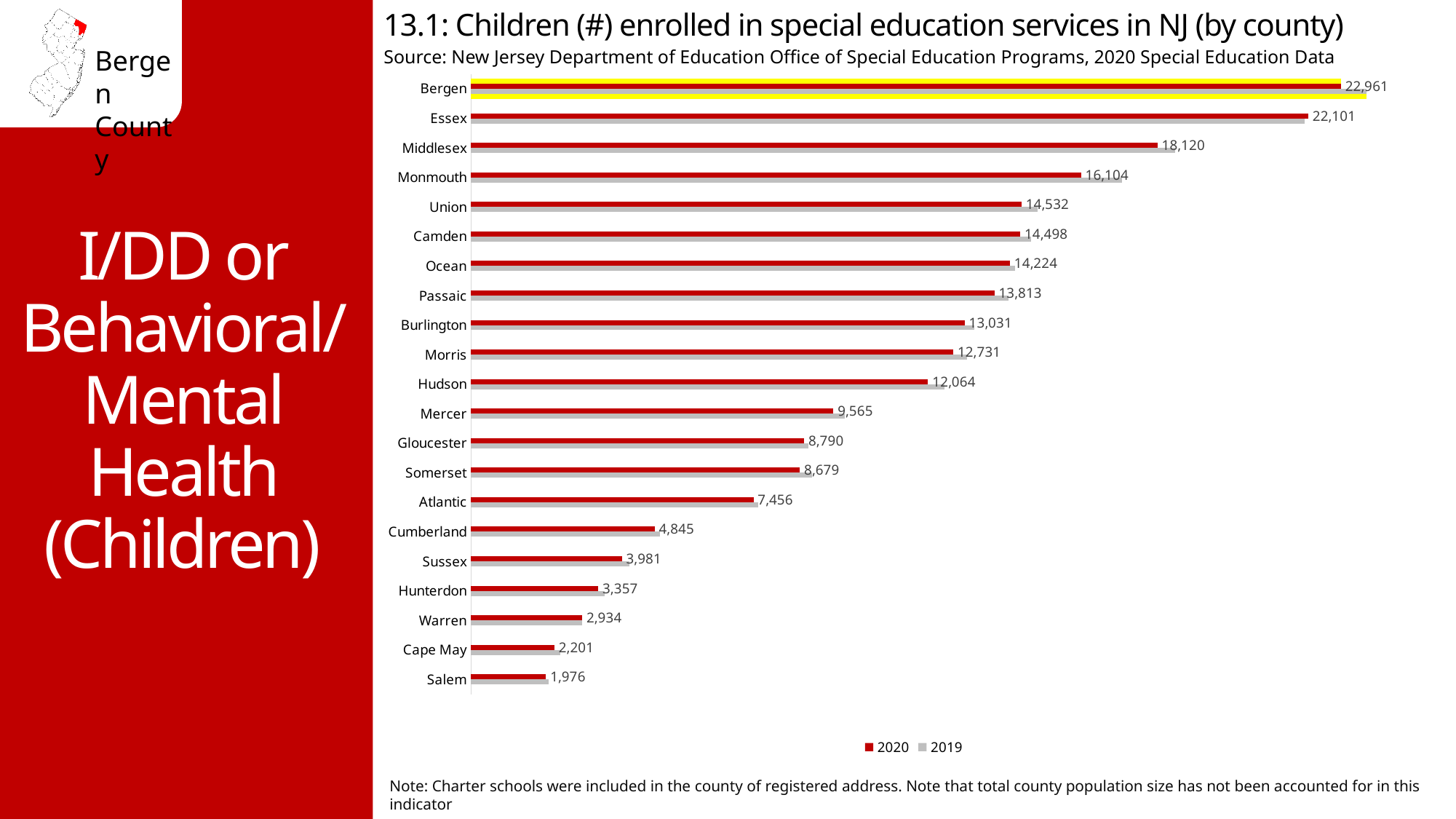
Which has a larger 2020 value, Mercer or Atlantic? Mercer What kind of chart is shown on the slide? bar chart What is the 2020 value for Cumberland? 4,845 What is the 2020 value for Middlesex? 18,120 What is the 2020 value for Bergen? 22,961 What is the difference between the 2020 values for Monmouth and Union? 1,572 Which series is shown in red? 2020 Which county has the lowest 2020 value? Salem How many series does the legend list? 2 How many counties are shown on the chart? 21 Which county has the highest 2020 value? Bergen What is the difference between the 2020 values for Bergen and Essex? 860